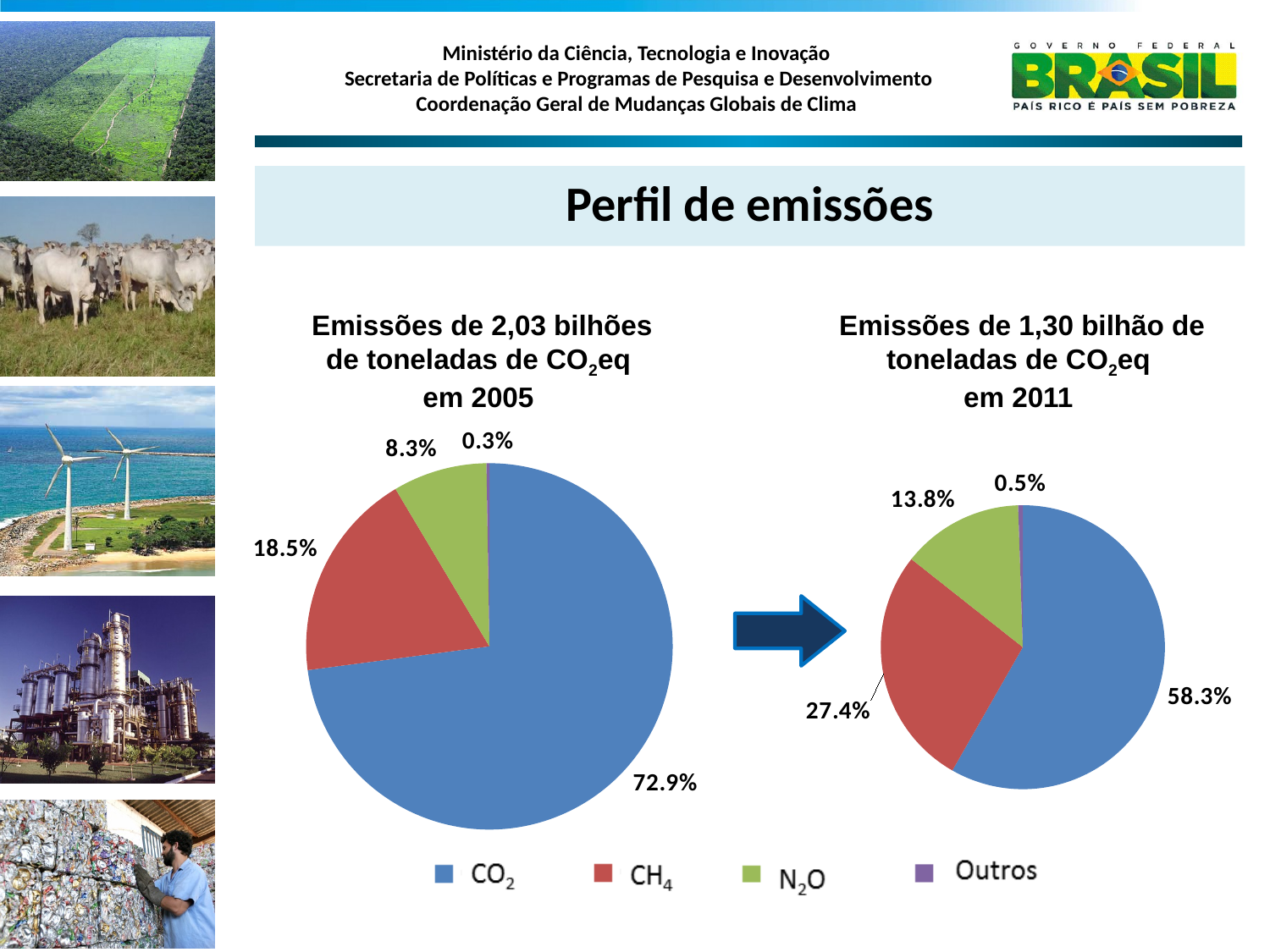
How many categories does the legend list for the pie charts? 4 In the 2011 pie chart (right), which category has the smallest share of emissions? Outros Is the CH4 share larger in the 2005 pie chart (left) or in the 2011 pie chart (right)? 2011 In the 2005 pie chart (left), what share of emissions is CO2? 72.9% In the 2005 pie chart (left), what share of emissions is labelled Outros? 0.3% What is the difference in percentage points between the CO2 share in 2005 (left chart) and in 2011 (right chart)? 14.6 According to the title of the left chart, what was the total amount of emissions in 2005? 2,03 bilhões de toneladas de CO2eq In the 2011 pie chart (right), what share of emissions is CH4? 27.4% What type of chart is used to show the emissions profile for 2005 and 2011? Pie chart In the 2005 pie chart (left), which gas has the largest share of emissions? CO2 In the 2011 pie chart (right), what share of emissions is N2O? 13.8% In the 2011 pie chart (right), what is the combined share of CH4 and N2O? 41.2%